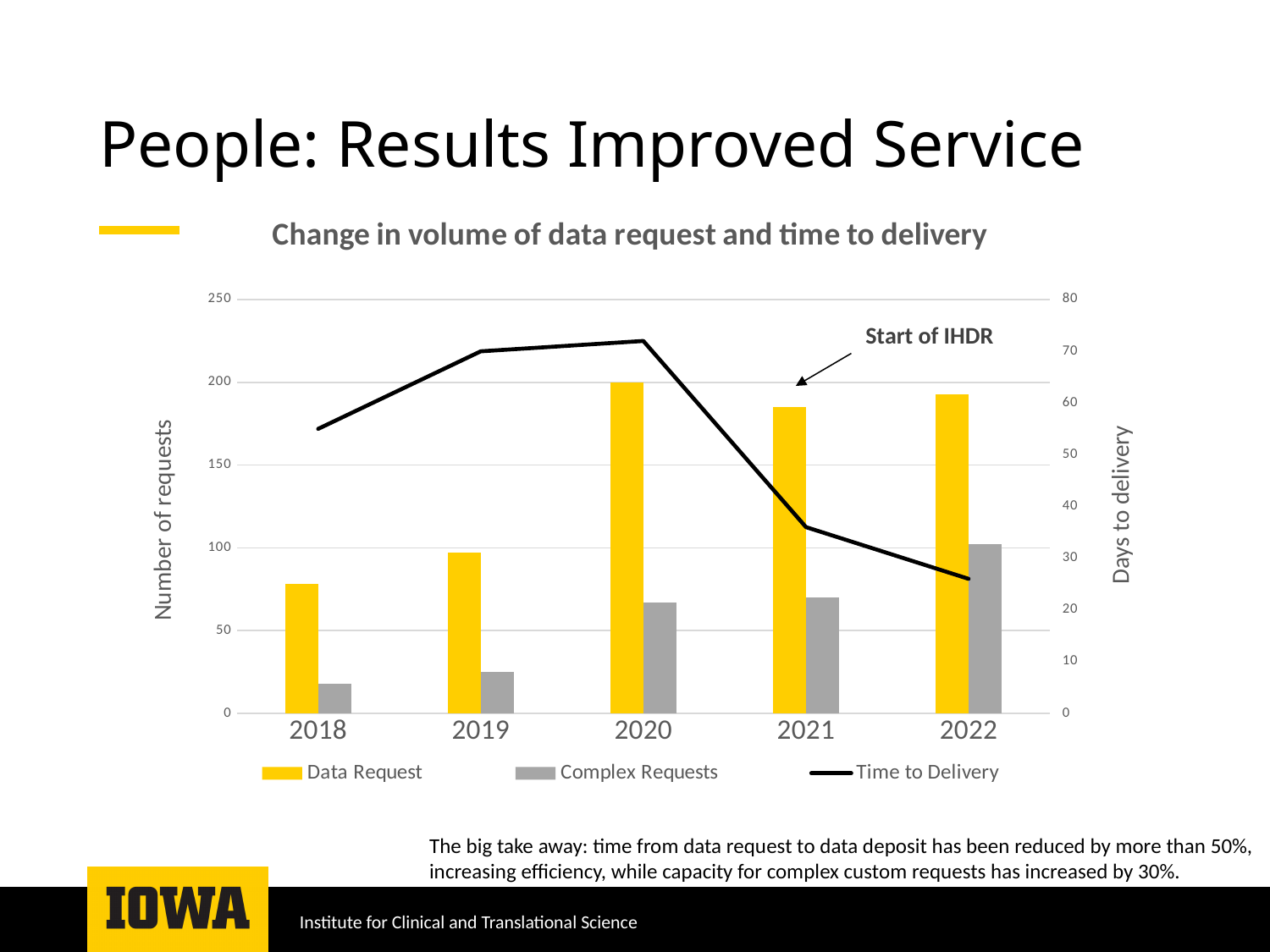
How many series does the chart legend list? 3 What kind of chart is shown on the slide? Combined bar and line chart Is the Data Request value for 2021 greater or less than 150? greater Which year has the lowest value for Time to Delivery? 2022 Do the Complex Requests values rise or fall from 2018 to 2022? rise Which year has the highest value for Complex Requests? 2022 What is the title of the chart? Change in volume of data request and time to delivery Which year has the lowest value for Data Request? 2018 Is the Time to Delivery value for 2022 greater or less than 30 days? less How many years are shown on the x axis of the chart? 5 Is the Data Request value for 2018 greater or less than 100? less Which is larger, the Data Request value for 2019 or for 2018? 2019